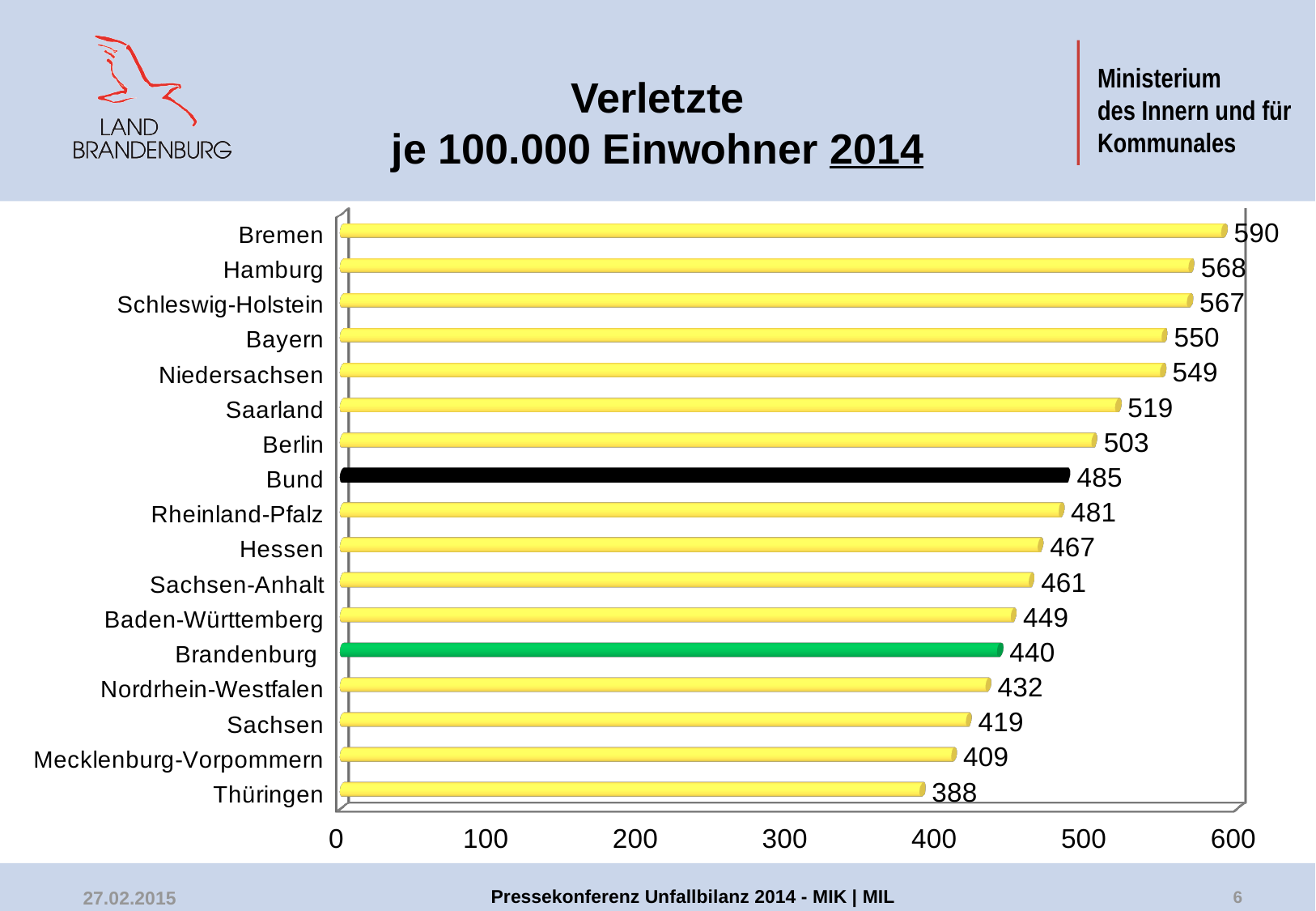
Which bar is coloured green? Brandenburg What kind of chart is shown on the slide? bar chart How many categories are shown in the chart? 17 What is the value for Bund? 485 Is the value for Sachsen greater or less than 400? greater What is the difference between the values for Bund and Brandenburg? 45 What is the difference between the values for Bremen and Thüringen? 202 Which is larger, the value for Saarland or the value for Berlin? Saarland What is the value for Brandenburg? 440 Which category has the lowest value? Thüringen Which category has the highest value? Bremen What is the value for Niedersachsen? 549